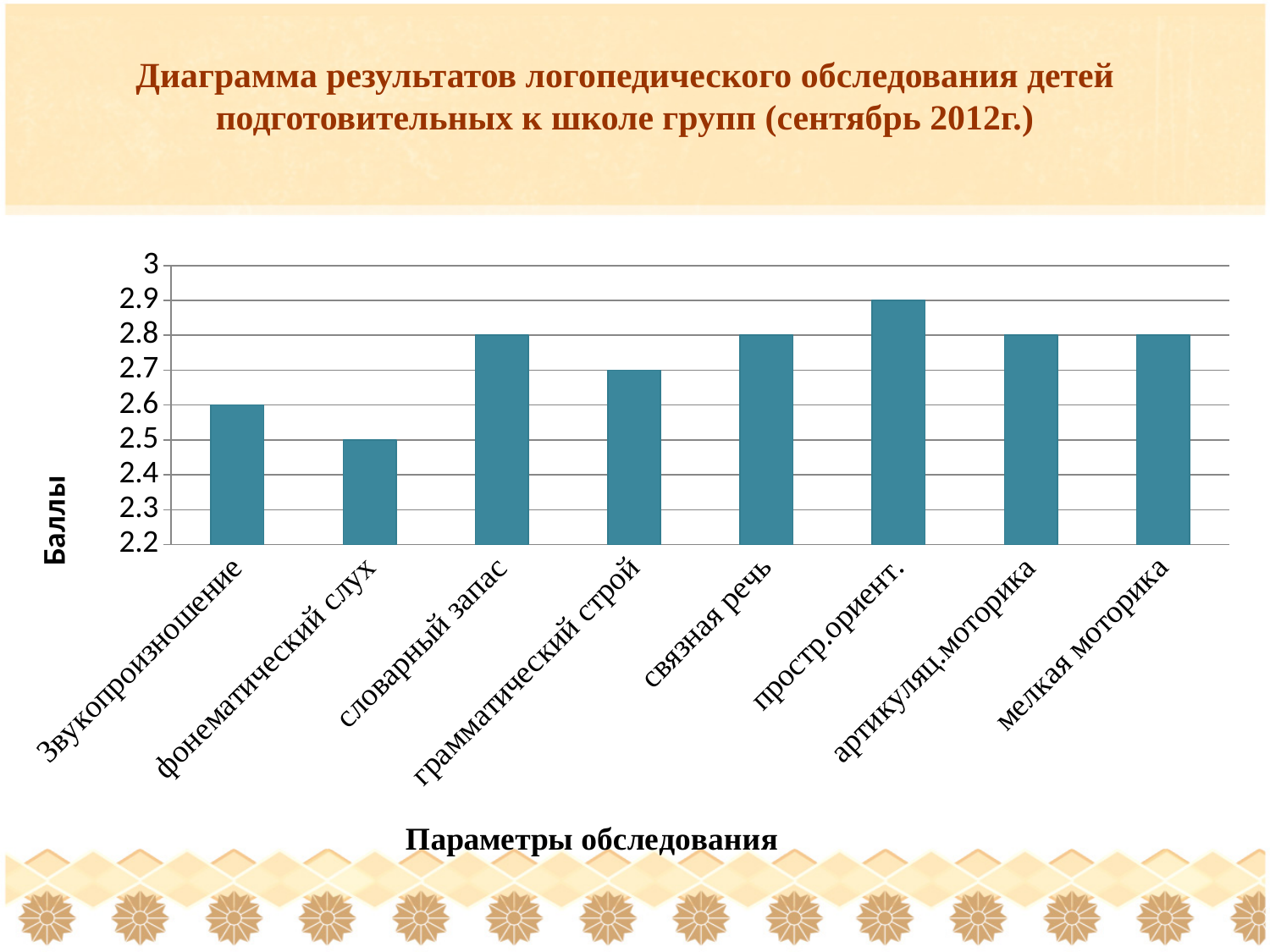
What is the difference between the values for простр.ориент. and фонематический слух? 0.4 What is the value for фонематический слух? 2.5 Which parameter has the lowest value? фонематический слух What is the value for простр.ориент.? 2.9 Which parameter has the highest value? простр.ориент. What is the value for грамматический строй? 2.7 Which is larger, the value for Звукопроизношение or the value for фонематический слух? Звукопроизношение Is the value for словарный запас greater or less than 2.7? greater What type of chart is shown on the slide? bar chart What is the title of the vertical axis? Баллы What is the value for Звукопроизношение? 2.6 How many categories (parameters) are plotted on the chart? 8